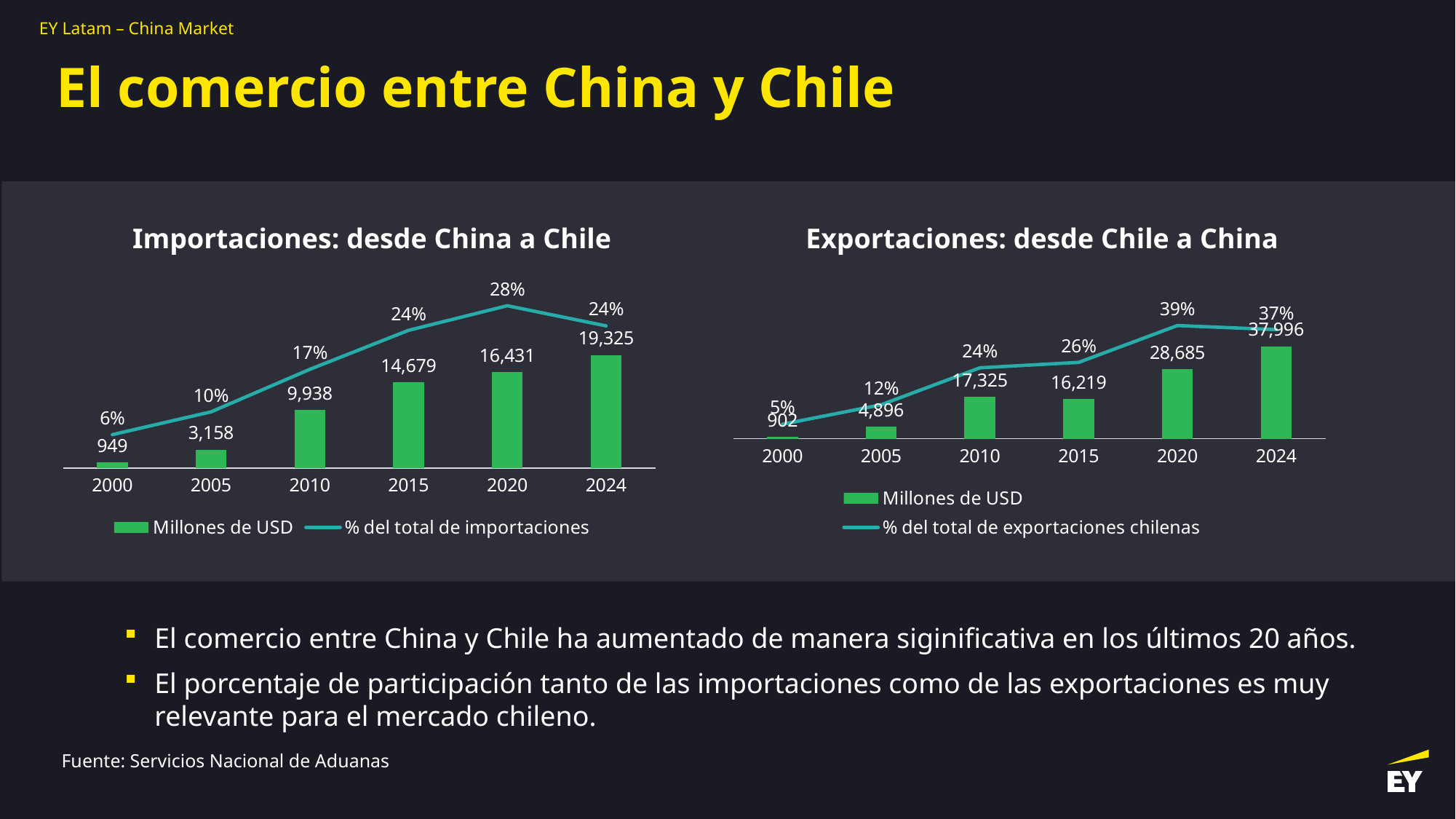
In the 'Importaciones: desde China a Chile' chart, what is the value in Millones de USD for 2015? 14,679 In the 'Exportaciones: desde Chile a China' chart, does the '% del total de exportaciones chilenas' rise or fall from 2000 to 2020? Rise How many series does the legend of the 'Exportaciones: desde Chile a China' chart list? 2 In the 'Importaciones: desde China a Chile' chart, what is the difference in Millones de USD between 2024 and 2020? 2,894 In the 'Importaciones: desde China a Chile' chart, which year has the highest value in Millones de USD? 2024 In the 'Exportaciones: desde Chile a China' chart, which is larger in Millones de USD: 2010 or 2015? 2010 In the 'Exportaciones: desde Chile a China' chart, which year has the lowest value in Millones de USD? 2000 In the 'Exportaciones: desde Chile a China' chart, what is the value in Millones de USD for 2020? 28,685 In the 'Importaciones: desde China a Chile' chart, what is the '% del total de importaciones' for 2020? 28% How many years are shown on the x axis of the 'Importaciones: desde China a Chile' chart? 6 In the 'Exportaciones: desde Chile a China' chart, what is the '% del total de exportaciones chilenas' for 2024? 37% What kind of chart is the 'Importaciones: desde China a Chile' chart? Combined bar and line chart